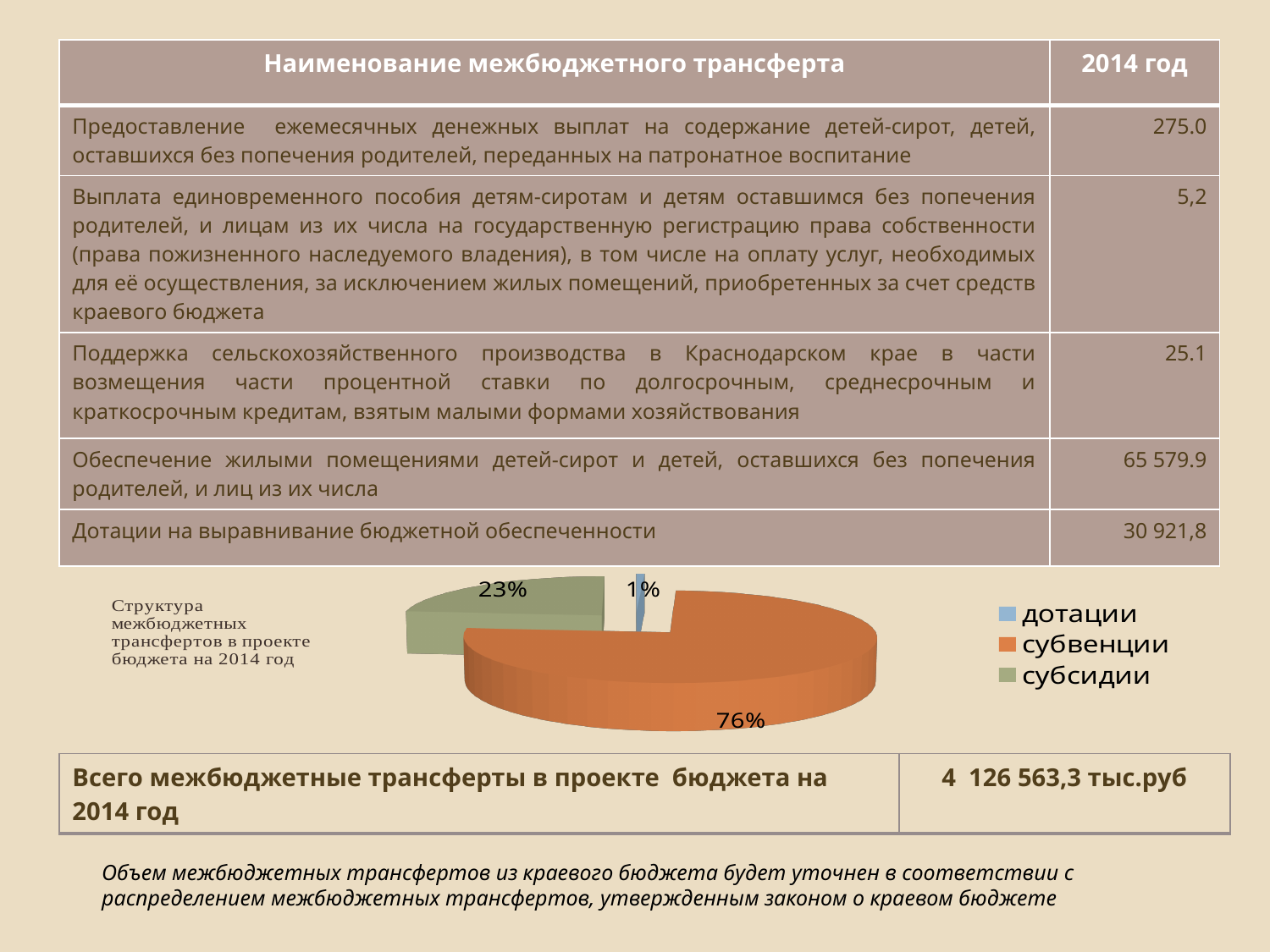
Which category has the smallest slice in the pie chart? дотации What share of the pie chart does субсидии account for? 23% Which category has the largest slice in the pie chart? субвенции How many entries does the chart legend list? 3 What is the difference in percentage points between the субвенции and субсидии slices? 53 How many slices does the pie chart have? 3 Which slice is larger, субсидии or дотации? субсидии What is the title of the pie chart? Структура межбюджетных трансфертов в проекте бюджета на 2014 год What share of the pie chart does субвенции account for? 76% What colour is the субвенции slice in the pie chart? orange What share of the pie chart does дотации account for? 1% What type of chart is shown on the slide? pie chart